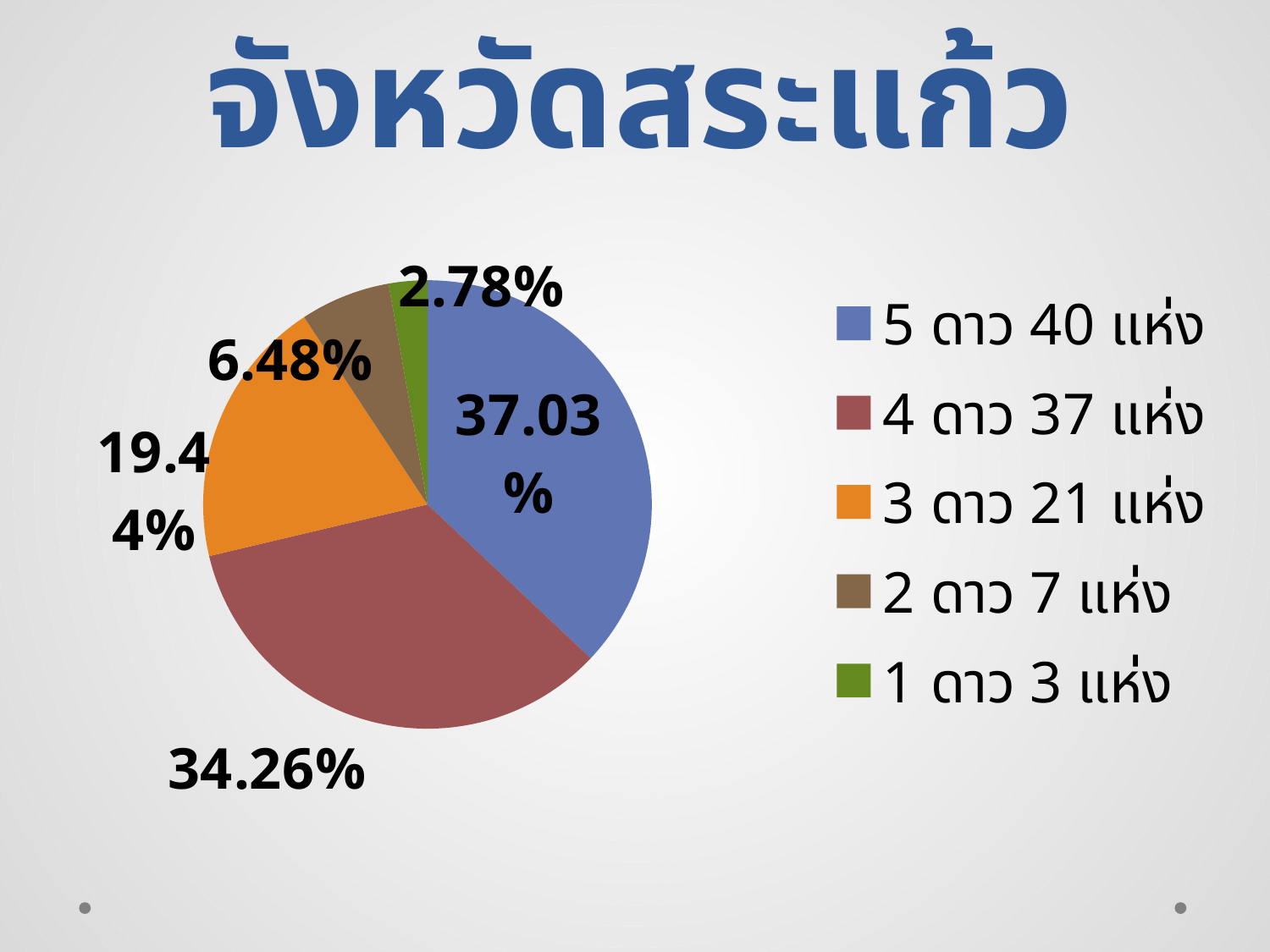
What is the difference in percentage points between the 5 ดาว slice and the 4 ดาว slice? 2.77 What is the title of the slide? จังหวัดสระแก้ว What type of chart is shown on the slide? pie chart What percentage is shown for the 5 ดาว slice? 37.03% What percentage is shown for the 4 ดาว slice? 34.26% What percentage is shown for the 2 ดาว slice? 6.48% Which category has the smallest share of the pie? 1 ดาว 3 แห่ง Which colour represents the 3 ดาว 21 แห่ง category in the legend? orange What percentage is shown for the 3 ดาว slice? 19.44% Which category has the largest share of the pie? 5 ดาว 40 แห่ง What percentage is shown for the 1 ดาว slice? 2.78% How many slices does the pie chart have? 5